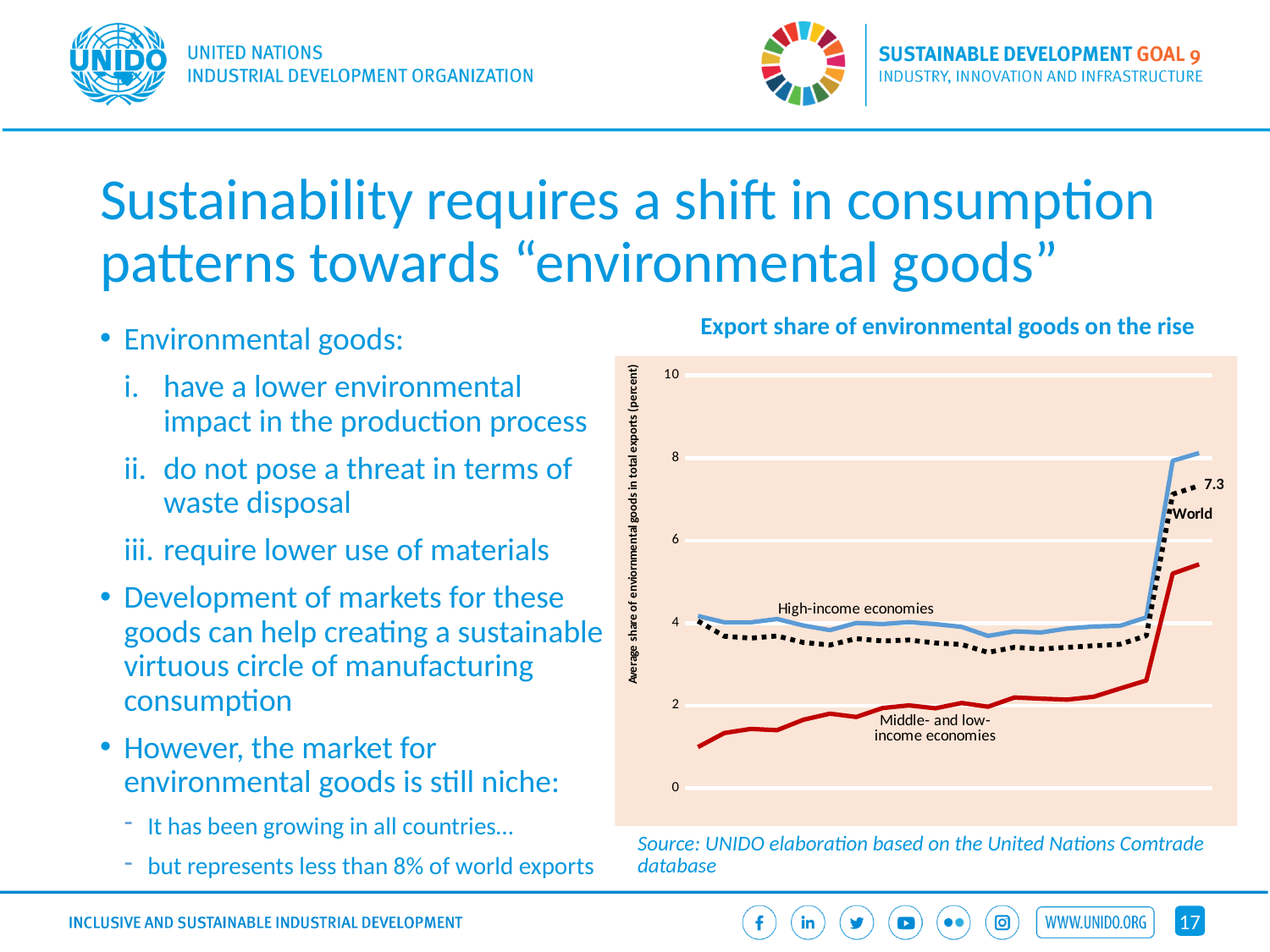
Is the final value for Middle- and low-income economies greater or less than 4? greater Which series has the highest value at the right end of the chart? High-income economies Which series has the lowest values throughout the chart? Middle- and low-income economies Does the Middle- and low-income economies line rise or fall overall along the x axis? rise What kind of chart is shown on the slide? line chart What is the label on the vertical axis of the chart? Average share of enviornmental goods in total exports (percent) Is the final value for High-income economies greater or less than 6? greater How many series are plotted in the chart? 3 What value is labelled at the end of the World line? 7.3 What is the title of the chart? Export share of environmental goods on the rise At the right end of the chart, which is larger: the value for High-income economies or for Middle- and low-income economies? High-income economies Is the first value for Middle- and low-income economies greater or less than 2? less